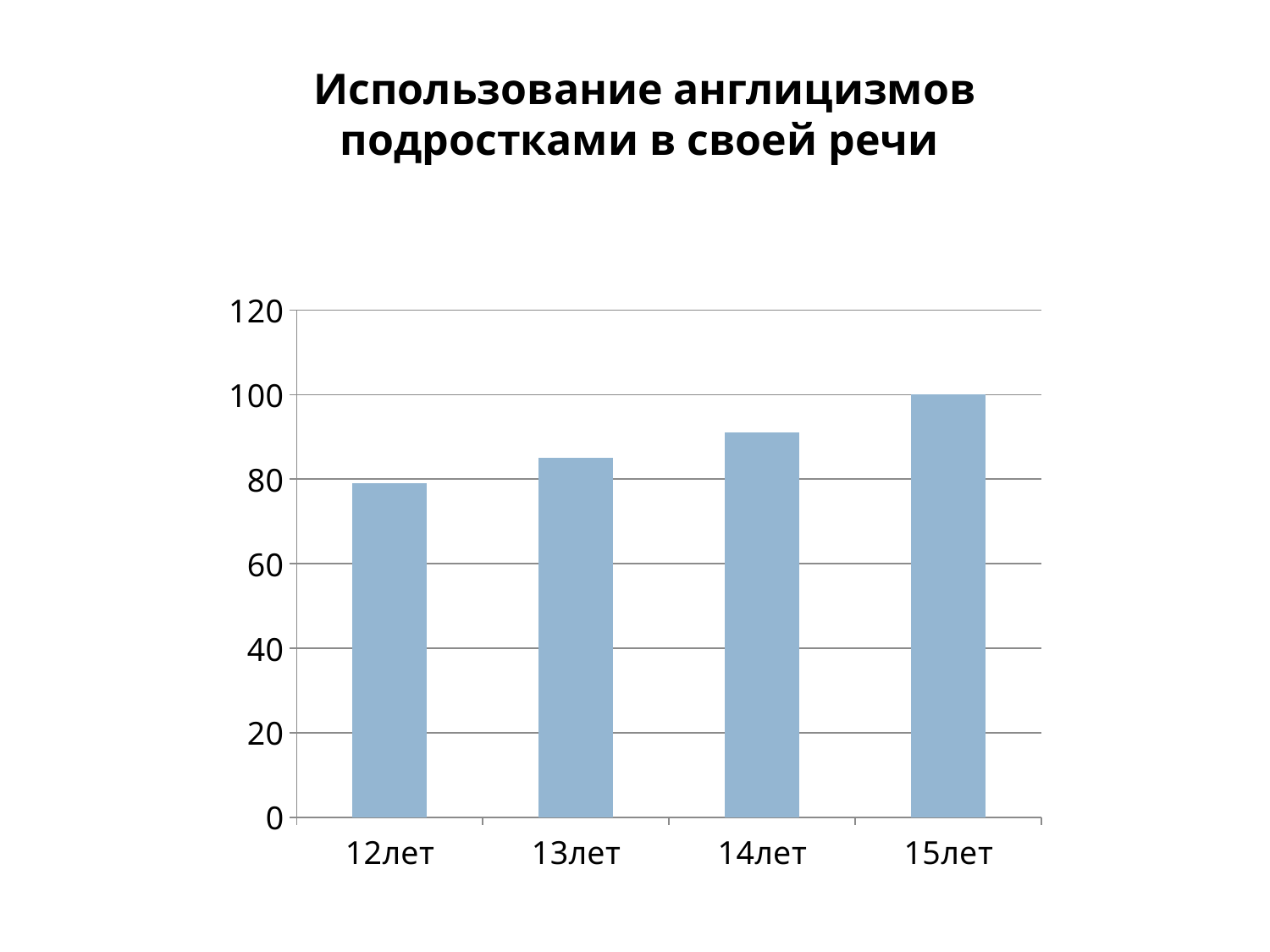
Is the value for 14лет greater or less than 100? less What is the title of the chart? Использование англицизмов подростками в своей речи What kind of chart is shown on the slide? bar chart Is the value for 13лет greater or less than 80? greater Do the values rise or fall from 12лет to 15лет? rise Which age group has the highest value? 15лет What is the highest value shown on the vertical axis? 120 How many age categories are shown on the x axis? 4 Which is larger, the value for 12лет or the value for 14лет? 14лет What is the value for 15лет? 100 Which age group has the lowest value? 12лет